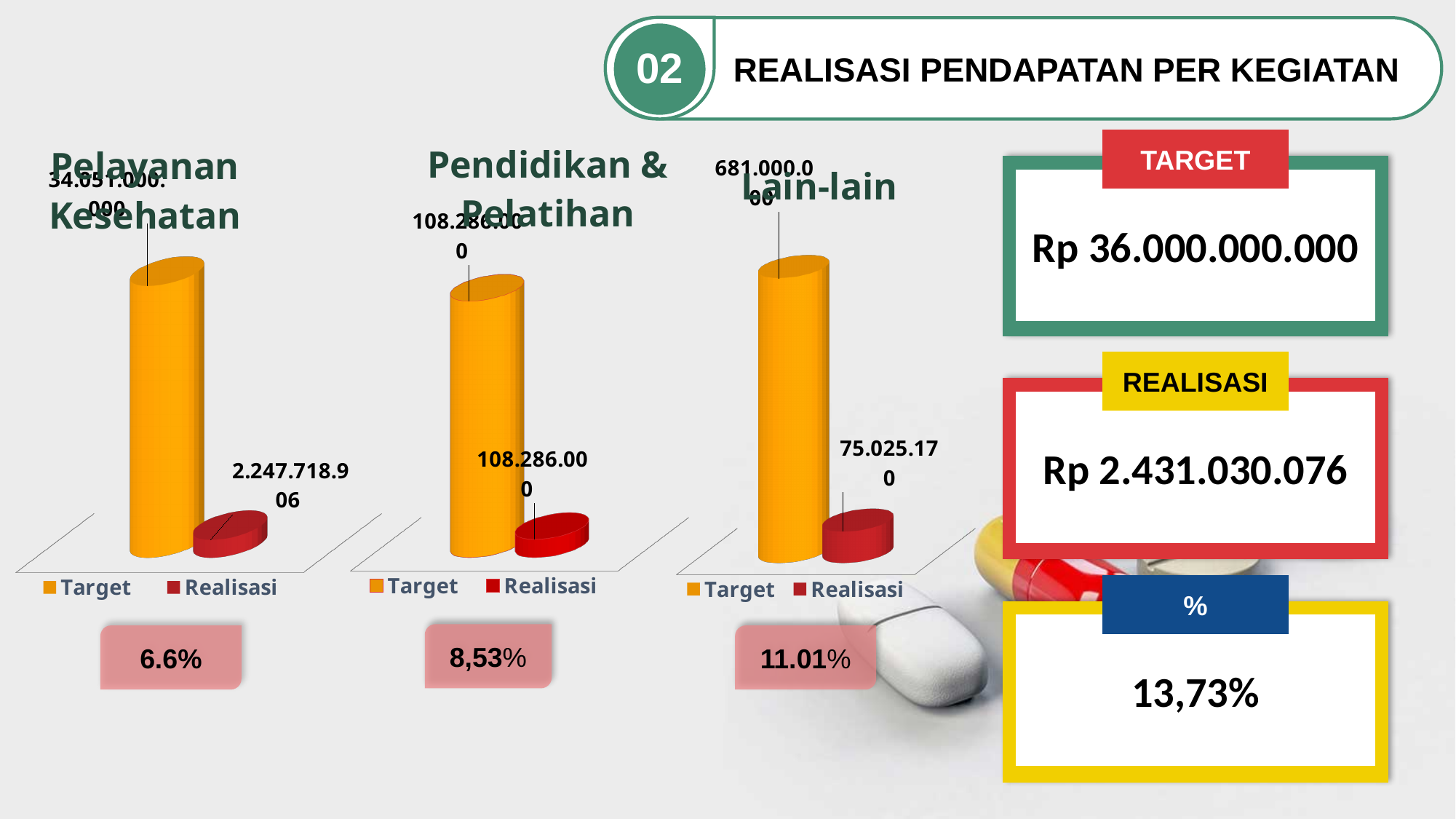
In the Lain-lain chart, which is larger, Target or Realisasi? Target How many series does the legend of the Pelayanan Kesehatan chart list? 2 What kind of chart is the Pendidikan & Pelatihan chart? Bar chart In the Pelayanan Kesehatan chart, what is the value of the Target bar? 34.051.000.000 In the Lain-lain chart, what is the difference between the Target and Realisasi values? 605.974.830 In the Lain-lain chart, what is the value of the Target bar? 681.000.000 How many charts are shown on the slide? 3 In the Pendidikan & Pelatihan chart, what is the value of the Realisasi bar? 108.286.000 In the Lain-lain chart, what is the value of the Realisasi bar? 75.025.170 In the Pelayanan Kesehatan chart, what is the value of the Realisasi bar? 2.247.718.906 In the Lain-lain chart, what colour are the Target bars? Orange In the Pelayanan Kesehatan chart, which bar is taller, Target or Realisasi? Target